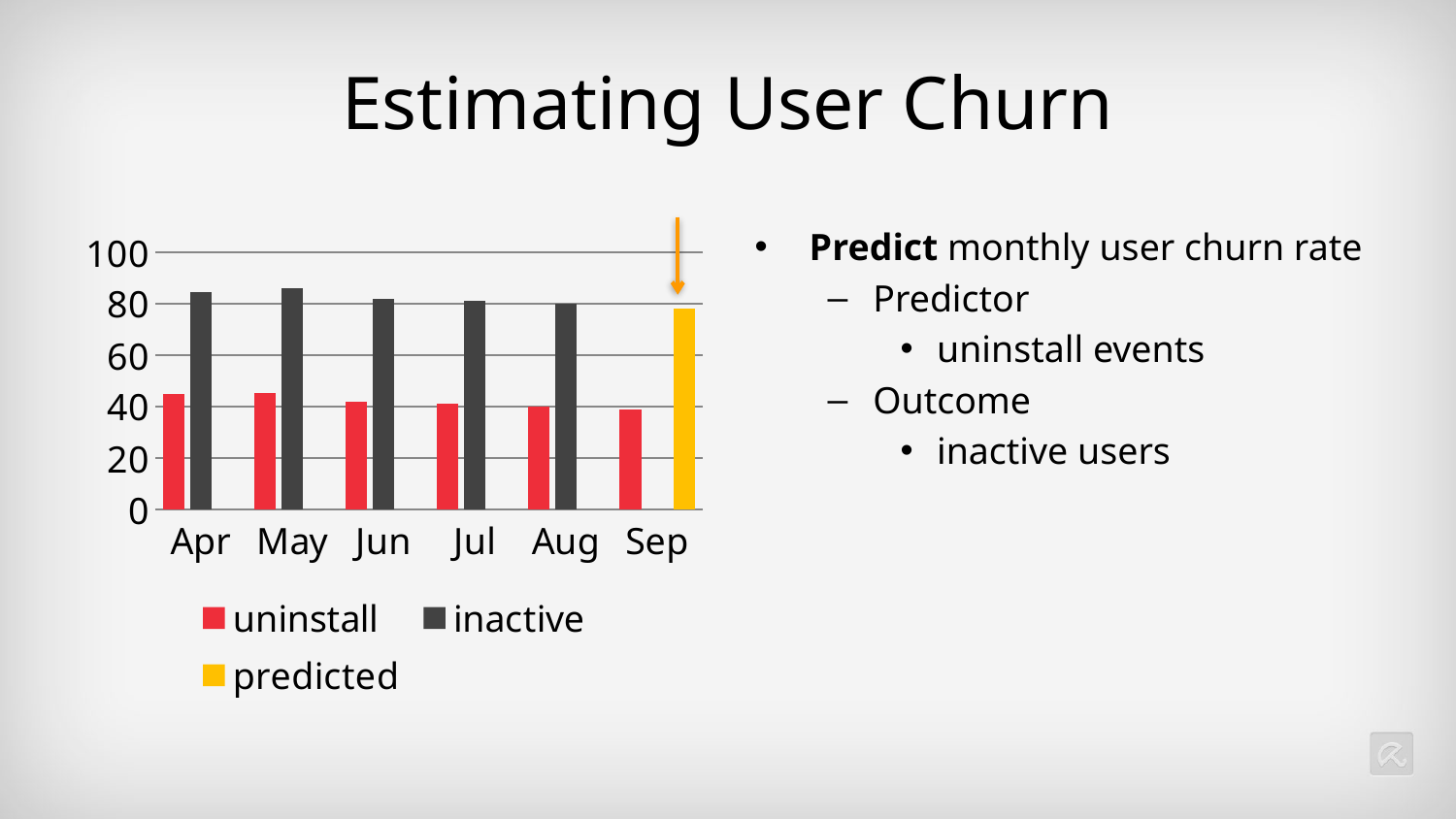
What kind of chart is shown on the slide? bar chart Is the inactive value for Apr greater or less than 60? greater Which series is shown in yellow in the chart legend? predicted Do the uninstall values generally rise or fall from Apr to Sep? fall How many series does the chart legend list? 3 Is the predicted value for Sep greater or less than 60? greater Is the inactive value for May greater or less than 80? greater In Jun, which is larger, the uninstall value or the inactive value? inactive In which month does the chart show a predicted bar? Sep How many months are shown on the x axis of the chart? 6